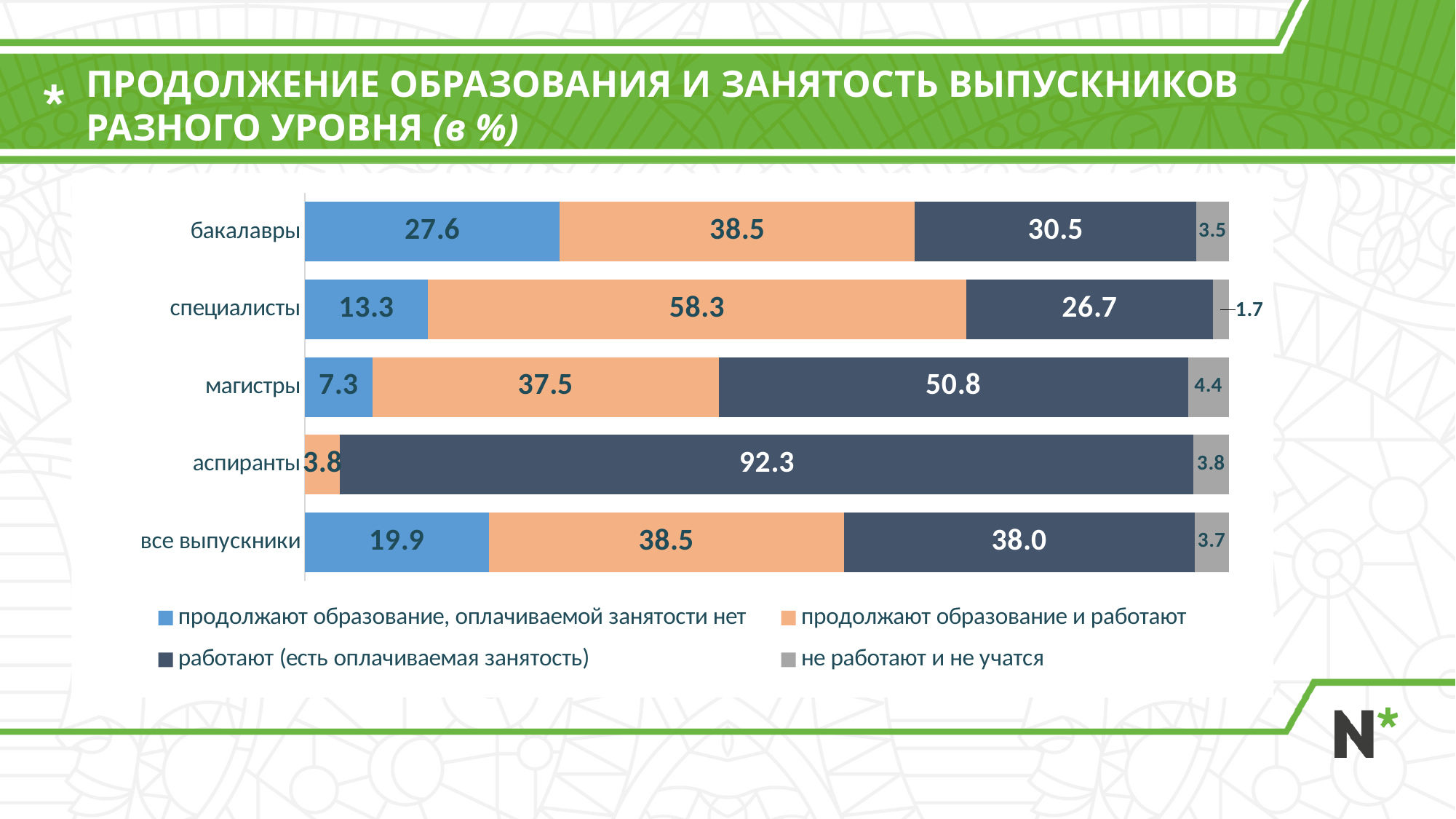
How many series does the legend list? 4 Which is larger: the «продолжают образование, оплачиваемой занятости нет» value for бакалавры or for все выпускники? бакалавры How many categories (graduate levels) are shown on the chart? 5 What is the total of the stacked bar for специалисты? 100.0 What type of chart is shown on the slide? stacked bar chart Which category has the lowest value for «не работают и не учатся»? специалисты What is the value for «не работают и не учатся» for аспиранты? 3.8 Which category has the highest value for «работают (есть оплачиваемая занятость)»? аспиранты What is the value for «продолжают образование и работают» for специалисты? 58.3 What is the value for «работают (есть оплачиваемая занятость)» for магистры? 50.8 What is the difference between the «продолжают образование и работают» values for специалисты and магистры? 20.8 What is the value for «продолжают образование, оплачиваемой занятости нет» for бакалавры? 27.6